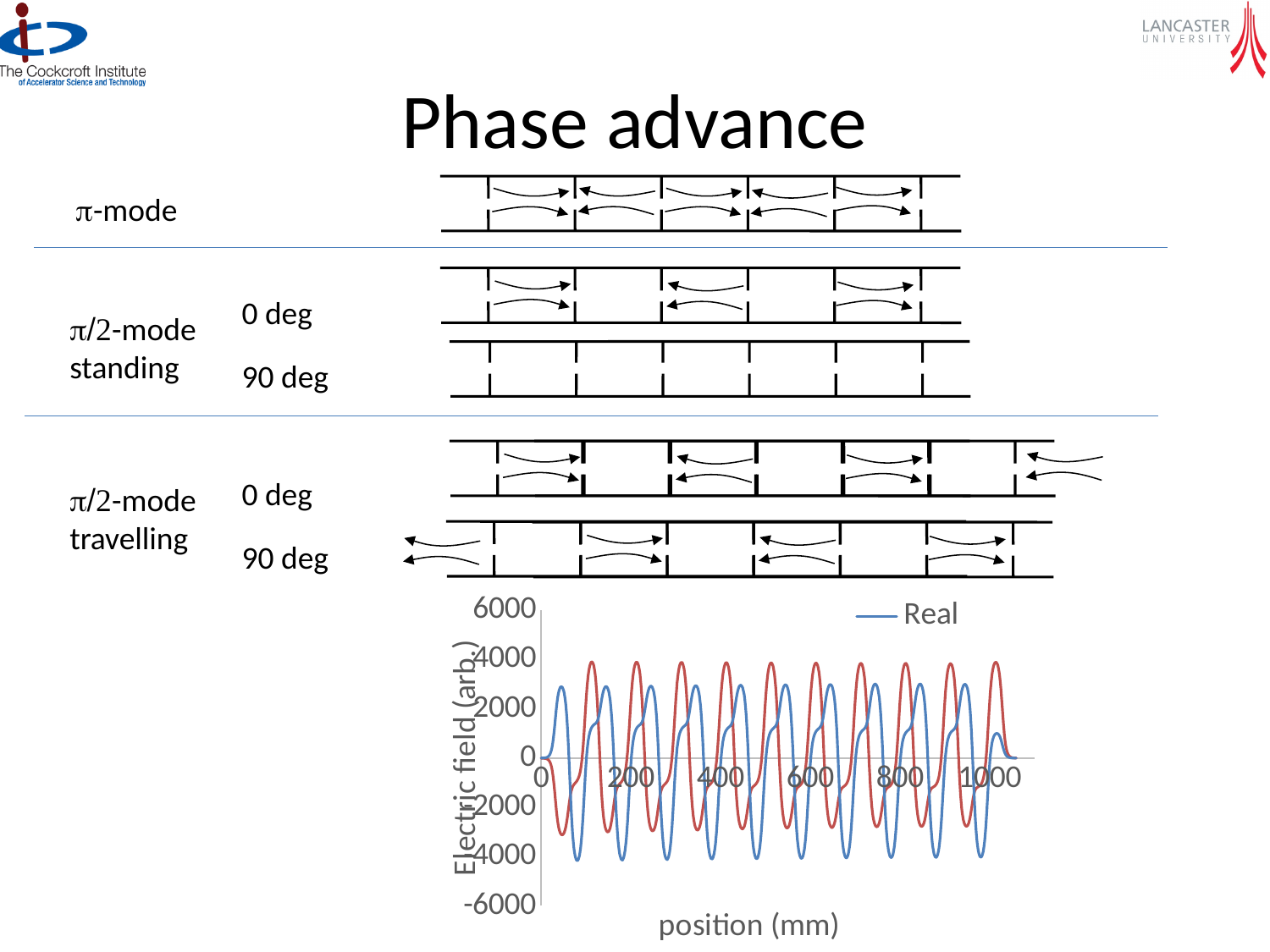
What is the y-axis title of the chart? Electric field (arb.) Is the lowest trough of the red series greater or less than -2000? less How many series does the chart's legend list? 1 Is the highest peak of the blue Real series greater or less than 2000? greater Is the highest peak of the blue Real series greater or less than 4000? less What is the x-axis title of the chart? position (mm) How many tick labels are shown on the x axis of the chart? 6 Which series reaches the higher positive peak, the red series or the blue Real series? the red series Which series reaches the lower negative trough, the red series or the blue Real series? the blue Real series What kind of chart is shown at the bottom of the slide? line chart